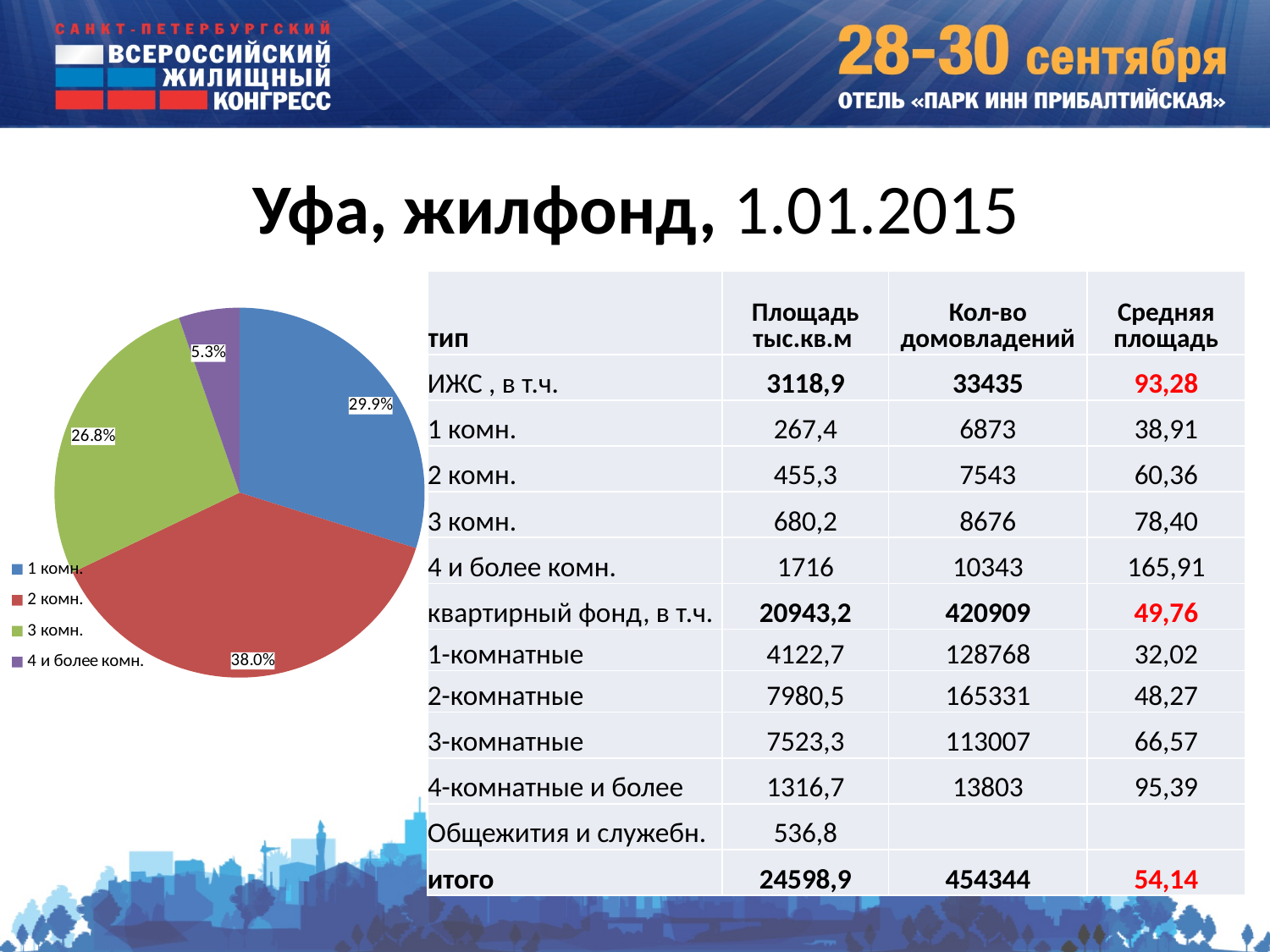
Which slice is larger in the pie chart, "1 комн." or "3 комн."? 1 комн. Which category has the smallest slice in the pie chart? 4 и более комн. What share of the pie does the "4 и более комн." slice represent? 5.3% What colour is the "3 комн." slice in the pie chart? green How many slices does the pie chart have? 4 What share of the pie does the "1 комн." slice represent? 29.9% Which category has the largest slice in the pie chart? 2 комн. How many entries does the pie chart's legend list? 4 What share of the pie does the "3 комн." slice represent? 26.8% What kind of chart is shown on the slide? pie chart What is the difference in percentage points between the "2 комн." and "4 и более комн." slices? 32.7